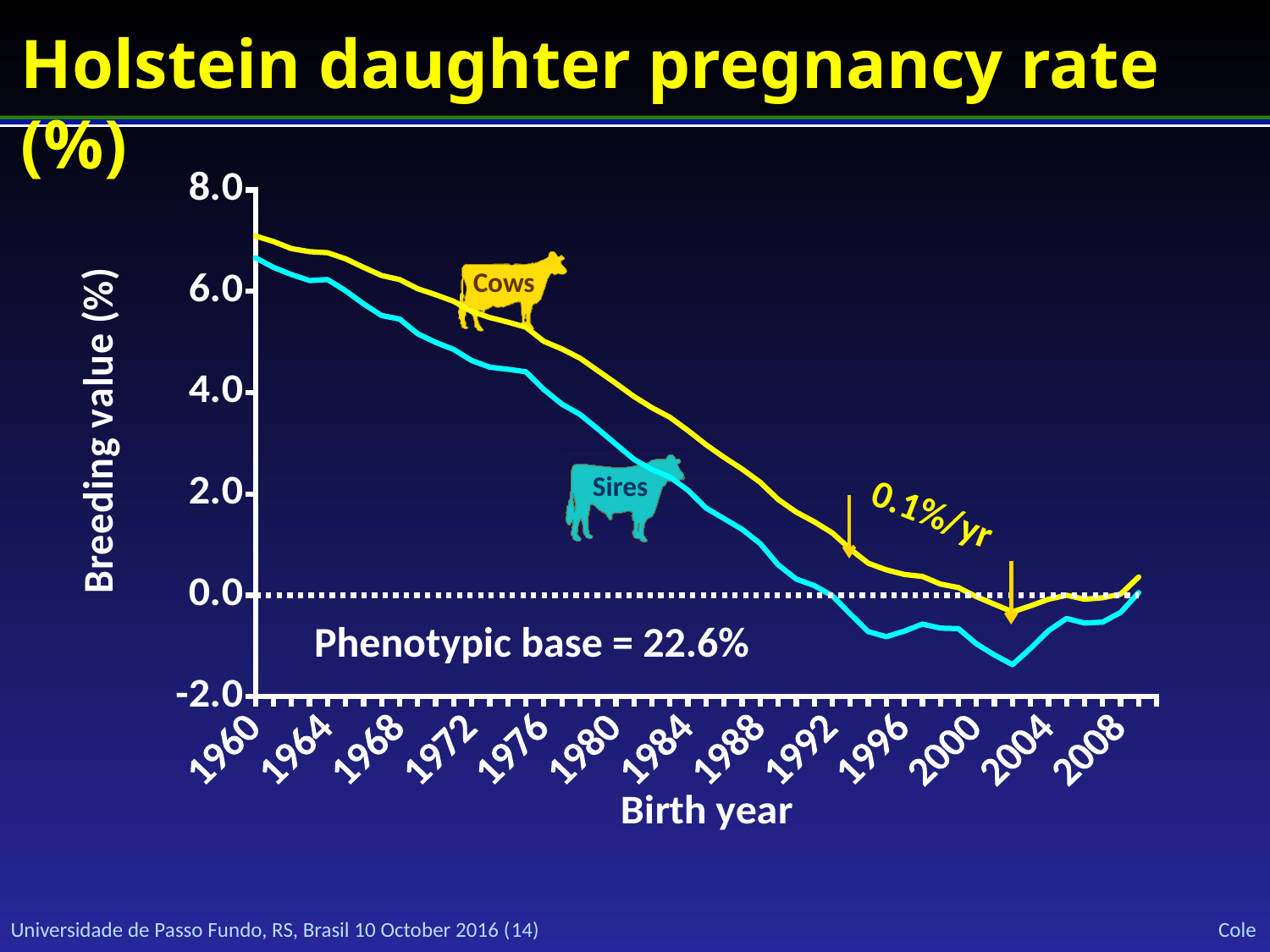
Is the breeding value for Cows in 1996 greater or less than 0.0? greater What is the label of the x axis? Birth year What kind of chart is shown on the slide? line chart Do the breeding values for Cows rise or fall from 1960 to 2004? fall Which series has the higher breeding value in 1960, Cows or Sires? Cows Is the breeding value for Sires in 1980 greater or less than 4.0? less What are the two series plotted on the chart? Cows and Sires Is the breeding value for Cows in 1960 greater or less than 6.0? greater What is the phenotypic base stated on the chart? 22.6%